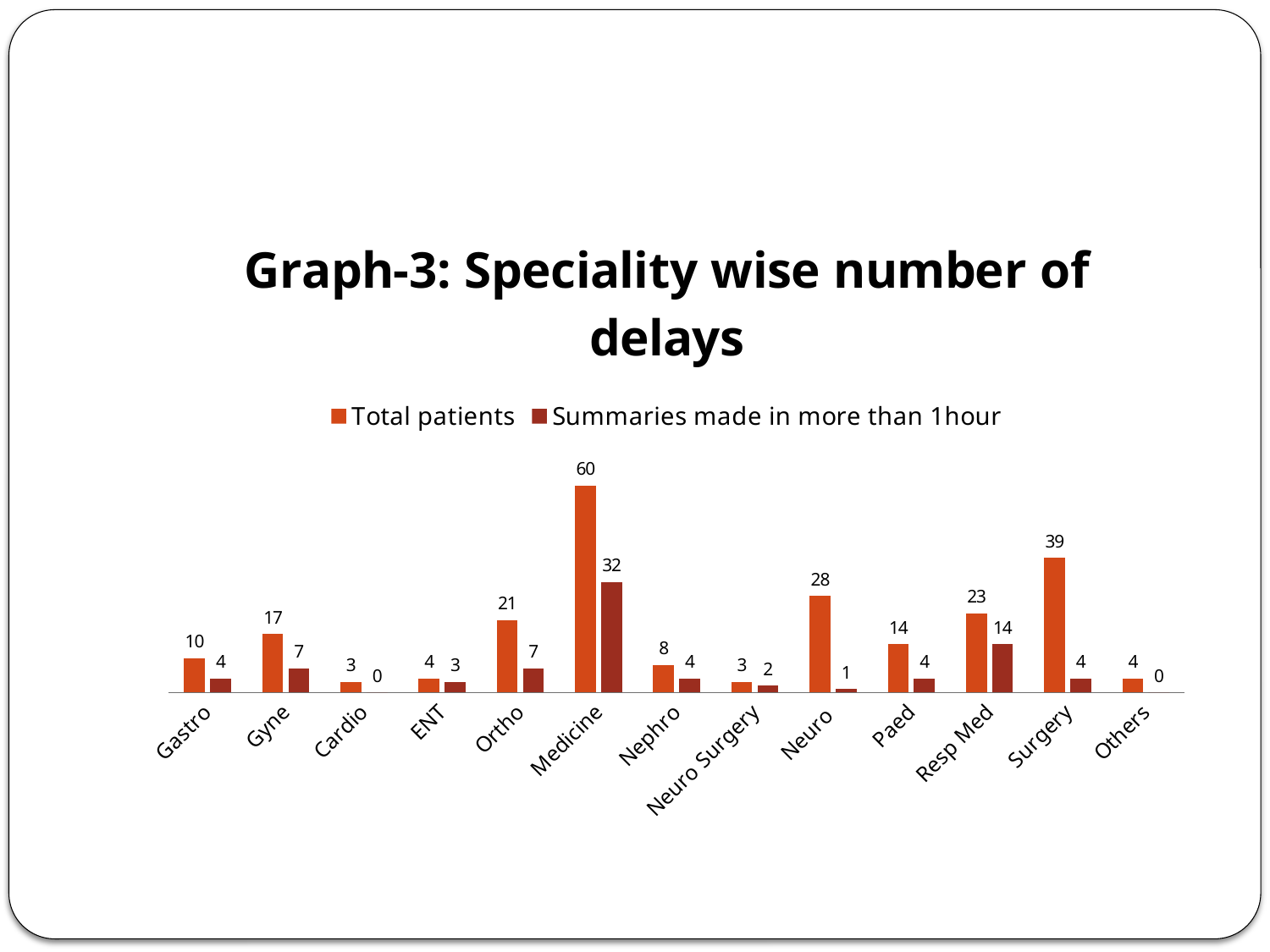
How many specialities are shown on the x axis? 13 Which is larger: Total patients for Neuro or Total patients for Surgery? Surgery What is the difference between Total patients for Surgery and Total patients for Neuro? 11 What is the difference between Total patients and Summaries made in more than 1hour for Medicine? 28 What is the value for Summaries made in more than 1hour in Surgery? 4 What kind of chart is shown on the slide? Bar chart How many series does the legend list? 2 What is the value for Total patients in Medicine? 60 Which speciality has the highest value for Total patients? Medicine What is the title of the chart? Graph-3: Speciality wise number of delays Which speciality has the lowest value for Summaries made in more than 1hour? Cardio and Others What is the value for Total patients in Resp Med? 23